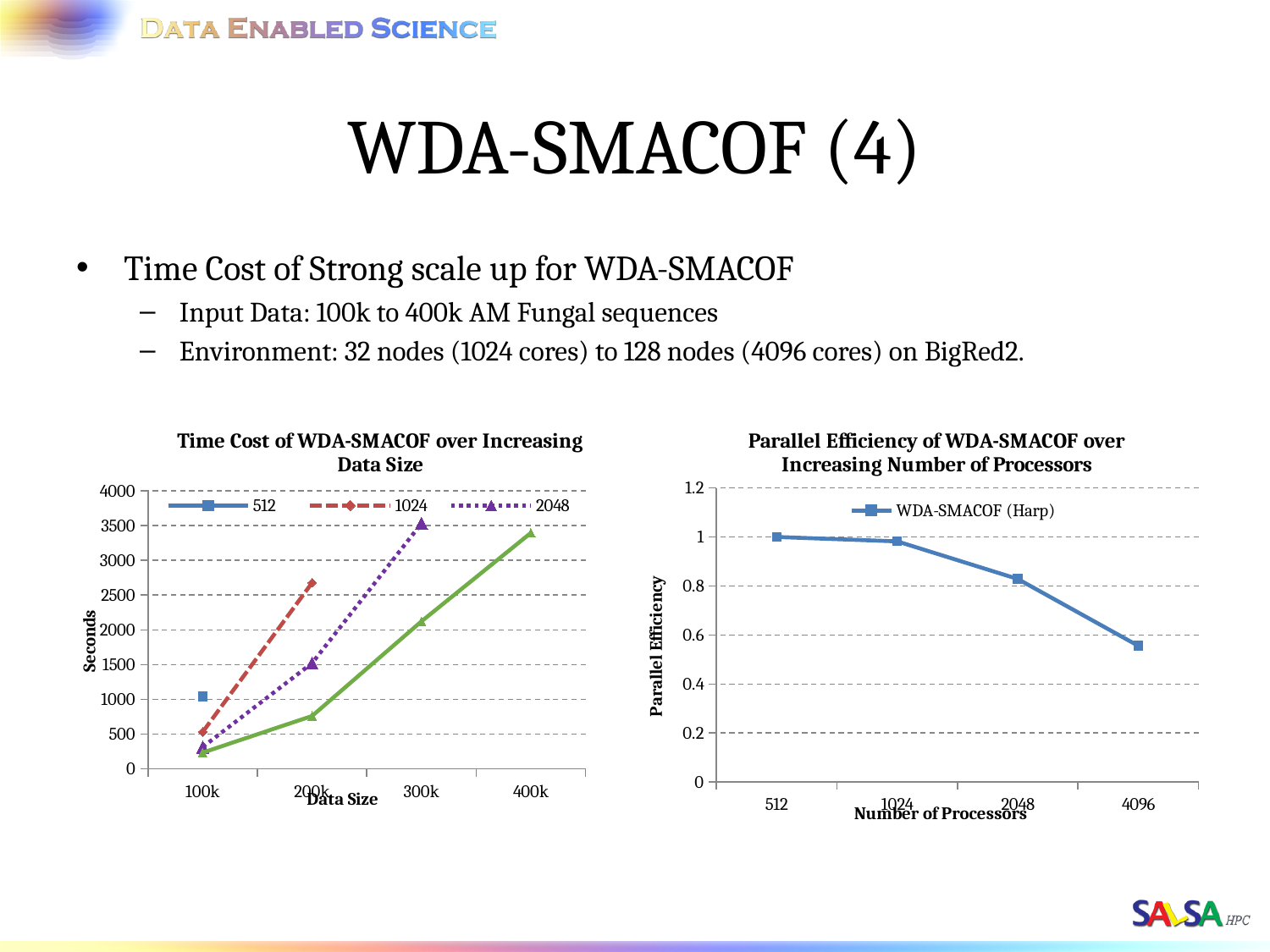
In the left chart, 'Time Cost of WDA-SMACOF over Increasing Data Size', at 100k data size, which series has the larger time cost, 512 or 1024? 512 In the right chart, 'Parallel Efficiency of WDA-SMACOF over Increasing Number of Processors', is the value for 4096 processors greater or less than 0.6? less In the right chart, 'Parallel Efficiency of WDA-SMACOF over Increasing Number of Processors', which number of processors has the highest parallel efficiency? 512 In the left chart, 'Time Cost of WDA-SMACOF over Increasing Data Size', how many series does the legend list? 3 In the right chart, 'Parallel Efficiency of WDA-SMACOF over Increasing Number of Processors', what is the parallel efficiency at 512 processors? 1 What kind of chart is the right chart, 'Parallel Efficiency of WDA-SMACOF over Increasing Number of Processors'? line chart In the right chart, 'Parallel Efficiency of WDA-SMACOF over Increasing Number of Processors', how many data points are plotted? 4 In the right chart, 'Parallel Efficiency of WDA-SMACOF over Increasing Number of Processors', which number of processors has the lowest parallel efficiency? 4096 In the right chart, 'Parallel Efficiency of WDA-SMACOF over Increasing Number of Processors', do the values rise or fall as the number of processors increases? fall What kind of chart is the left chart, 'Time Cost of WDA-SMACOF over Increasing Data Size'? line chart In the right chart, 'Parallel Efficiency of WDA-SMACOF over Increasing Number of Processors', what series name does the legend show? WDA-SMACOF (Harp) In the left chart, 'Time Cost of WDA-SMACOF over Increasing Data Size', is the value of the 2048 series at 300k greater or less than 3000 seconds? greater